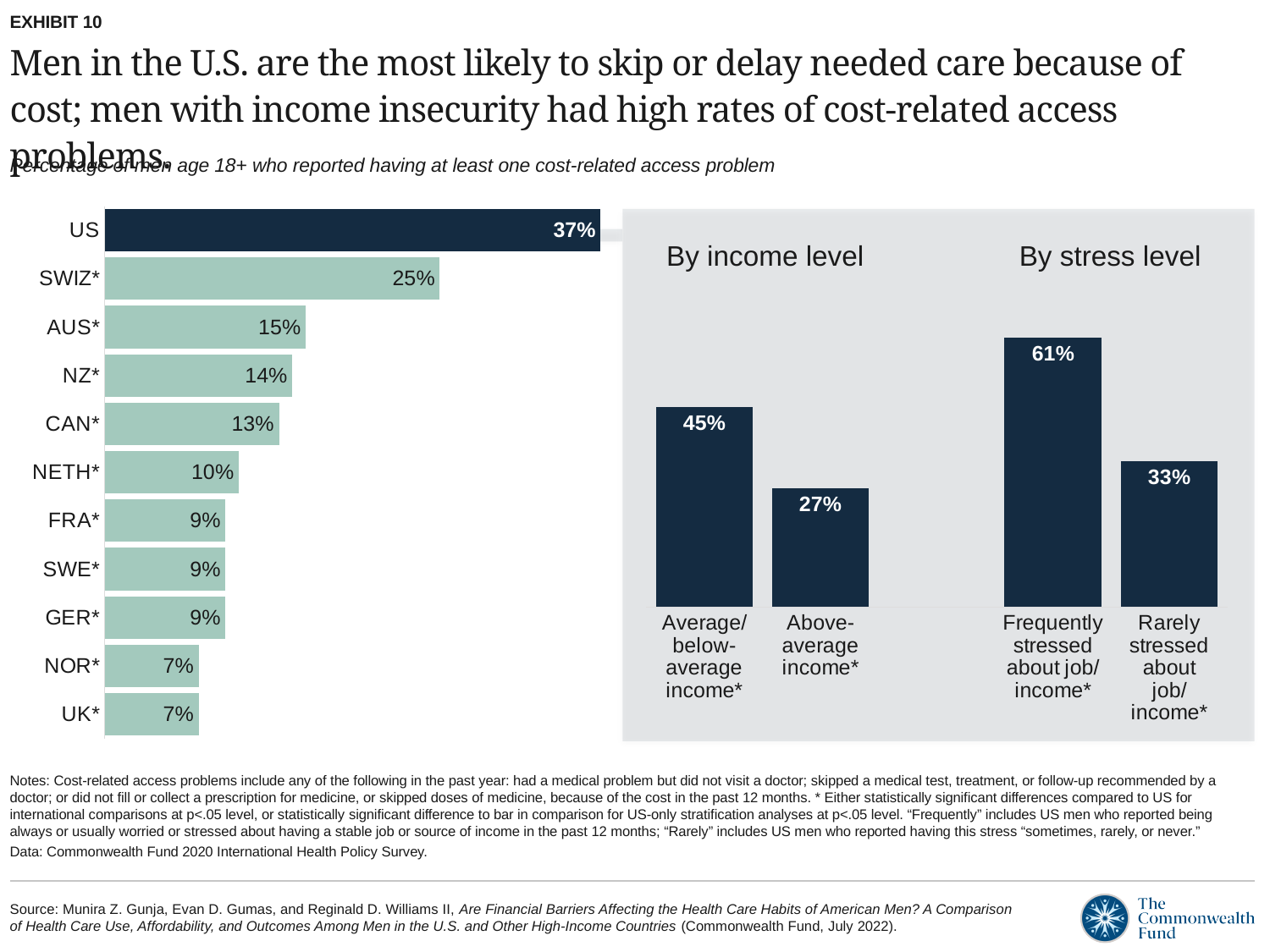
In the 'By income level' chart, what is the difference between the average/below-average income bar and the above-average income bar? 18 percentage points In the country bar chart on the left, what is the value for SWIZ*? 25% In the 'By income level' chart, what is the value for men with average/below-average income? 45% In the country bar chart on the left, what percentage of men in the US reported at least one cost-related access problem? 37% In the country bar chart on the left, which country has the highest value? US In the 'By stress level' chart, which bar is higher, frequently stressed or rarely stressed? Frequently stressed In the country bar chart on the left, which is larger, the value for AUS* or the value for CAN*? AUS* What kind of chart is the country chart on the left of the slide? Bar chart In the 'By stress level' chart, what is the value for men frequently stressed about job/income? 61% In the country bar chart on the left, what is the difference between the US value and the SWIZ* value? 12 percentage points In the country bar chart on the left, what is the value for NETH*? 10% In the country bar chart on the left, how many countries are shown? 11